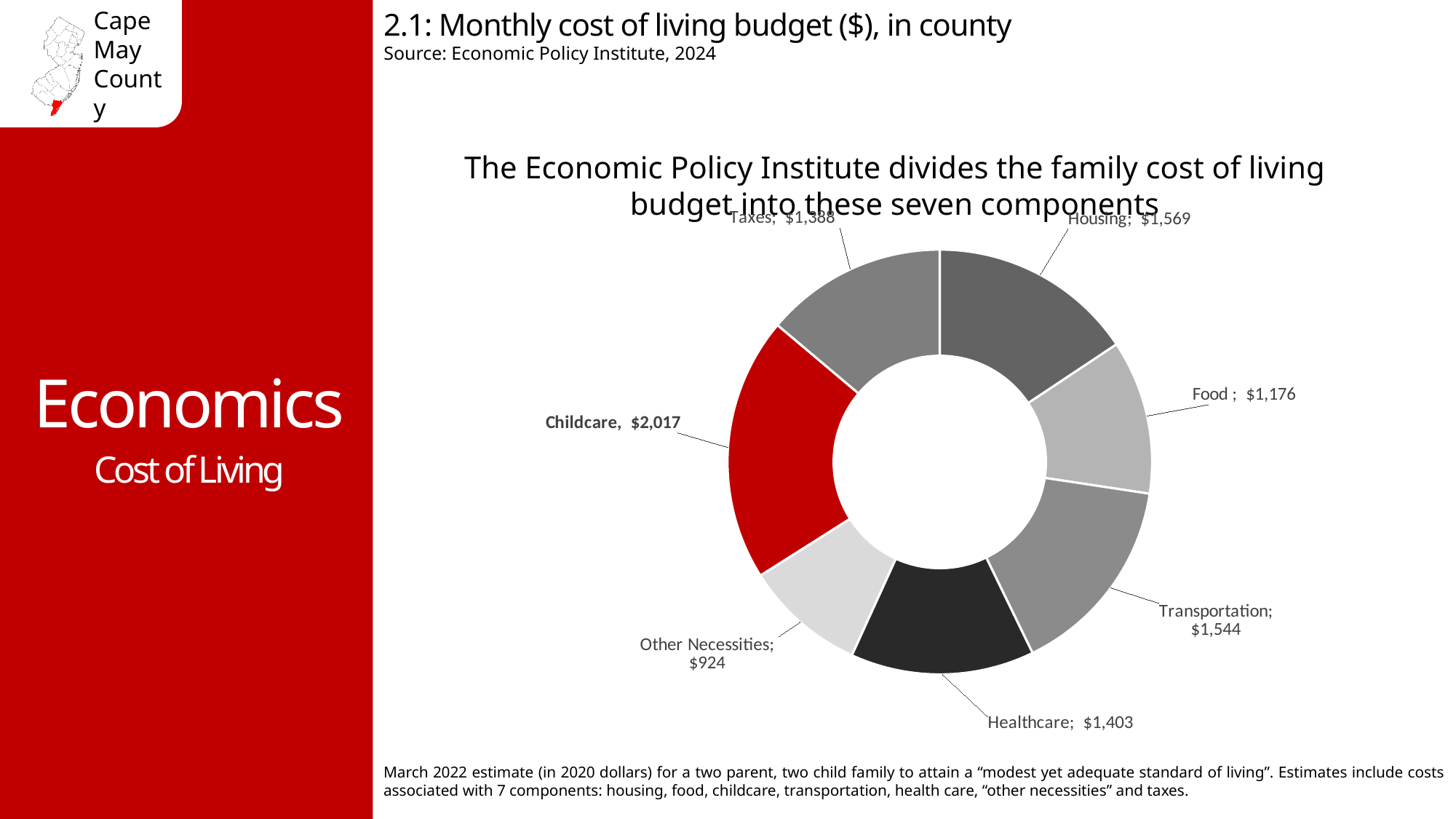
What is the monthly cost for Transportation? $1,544 Which component's slice is coloured red? Childcare What is the difference between the Childcare cost and the Housing cost? $448 Which component has the highest monthly cost? Childcare What is the monthly cost for Childcare? $2,017 What is the difference between the Food cost and the Other Necessities cost? $252 What is the monthly cost for Other Necessities? $924 Which is larger, the Healthcare cost or the Taxes cost? Healthcare What kind of chart is used to show the monthly cost of living budget? doughnut chart How many components are shown in the chart? 7 Which component has the lowest monthly cost? Other Necessities What is the monthly cost for Housing? $1,569